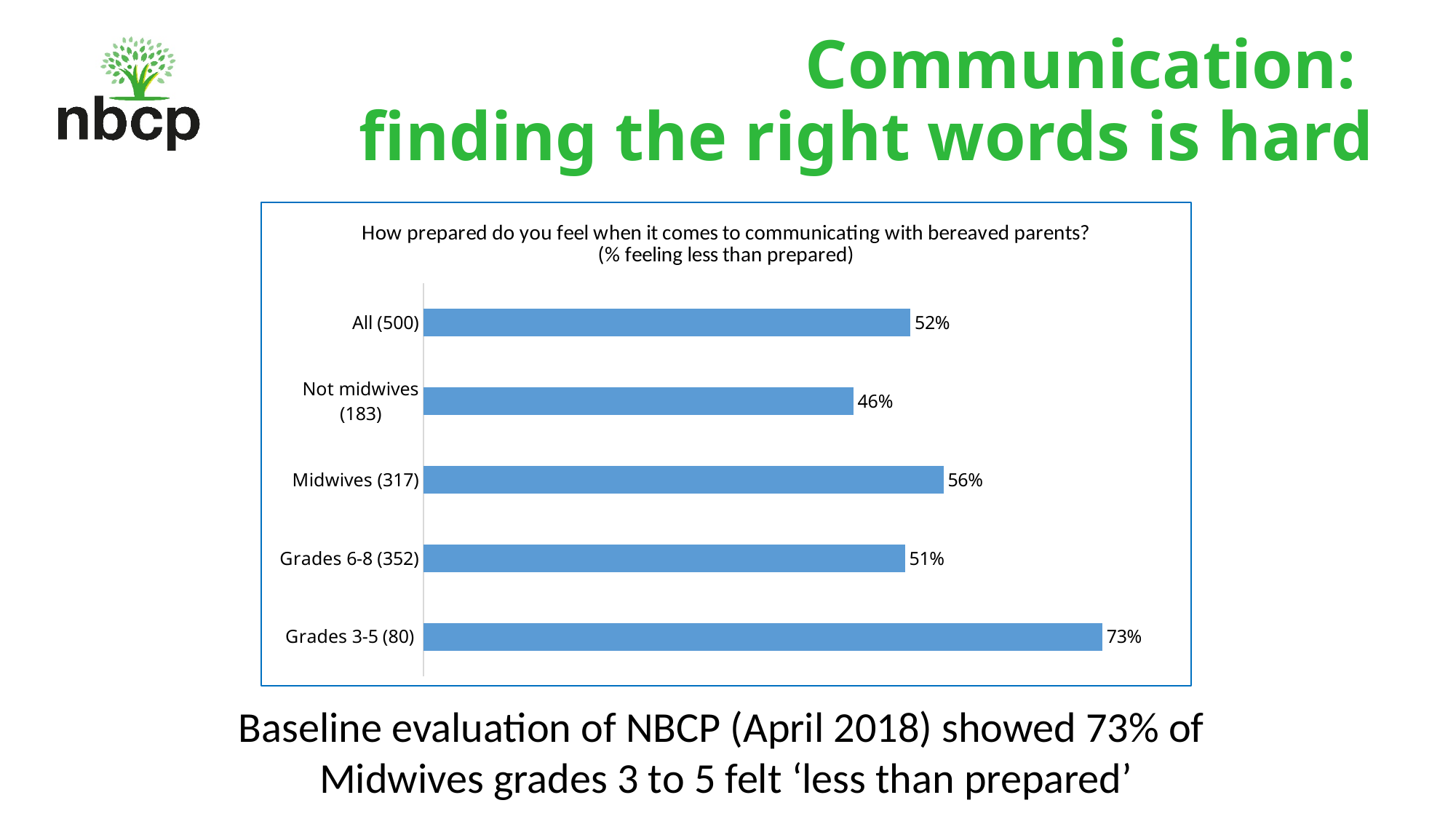
What kind of chart is shown on the slide? Bar chart How many categories are shown in the chart? 5 Which is larger, the value for Midwives (317) or the value for All (500)? Midwives (317) What is the value shown for All (500)? 52% Which category has the lowest percentage feeling less than prepared? Not midwives (183) What percentage of Midwives (317) felt less than prepared when communicating with bereaved parents? 56% Which category has the highest percentage feeling less than prepared? Grades 3-5 (80) What question does the chart title say respondents were asked? How prepared do you feel when it comes to communicating with bereaved parents? What is the difference in percentage points between Midwives (317) and Not midwives (183)? 10 What is the value shown for Not midwives (183)? 46% What is the value shown for Grades 3-5 (80)? 73% What is the difference in percentage points between Grades 3-5 (80) and Grades 6-8 (352)? 22